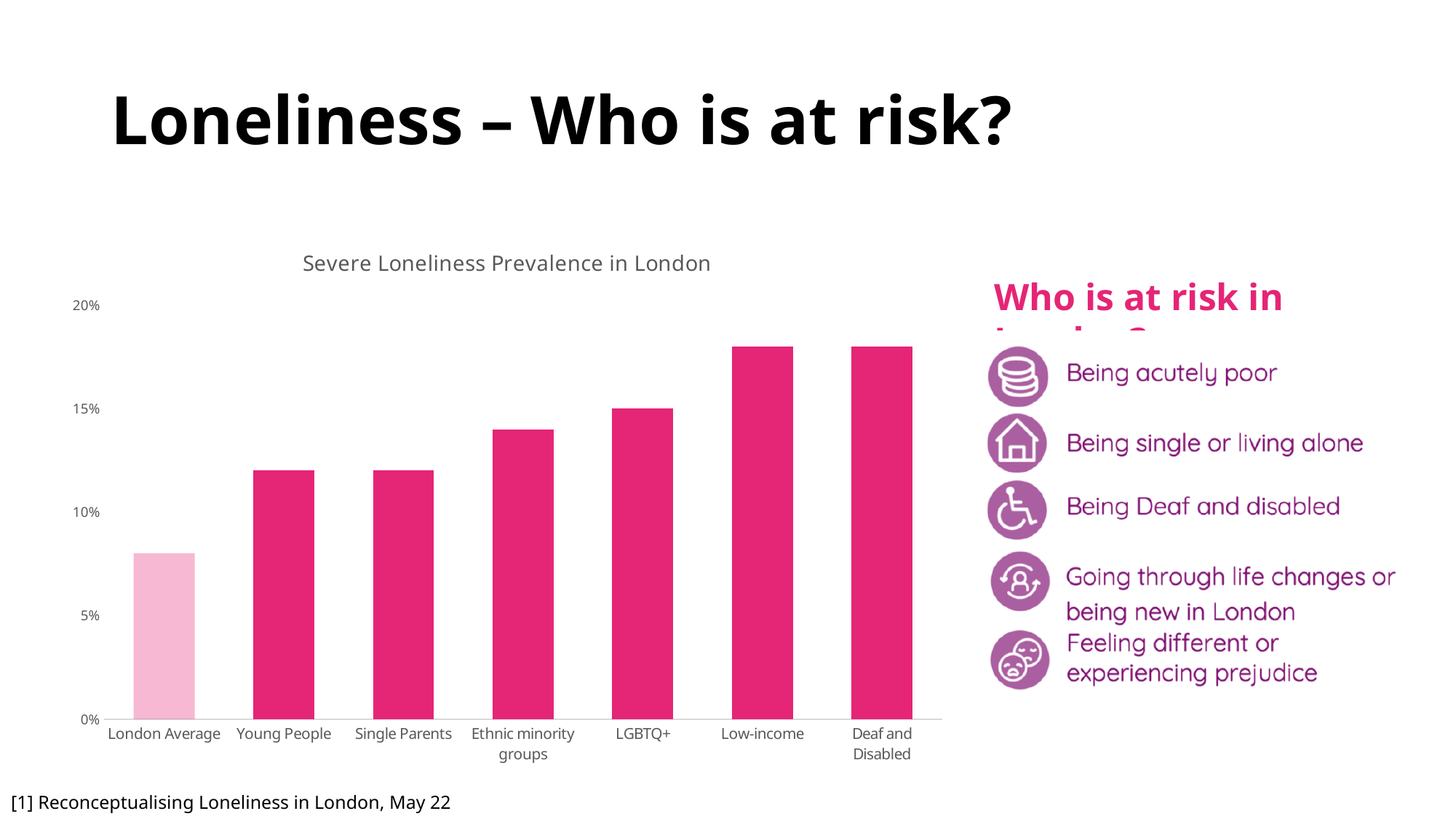
What is the title of the chart? Severe Loneliness Prevalence in London Is the value for Low-income greater or less than 15%? greater Which category has the lowest value in the chart? London Average Which is larger, the value for Low-income or the value for LGBTQ+? Low-income Do the bar values generally rise or fall from left to right along the x axis? Rise Is the value for Ethnic minority groups greater or less than 15%? less What kind of chart is shown on the slide? Bar chart How many categories are shown on the x axis of the chart? 7 Is the value for Deaf and Disabled greater or less than 20%? less Which is larger, the value for Ethnic minority groups or the value for Young People? Ethnic minority groups